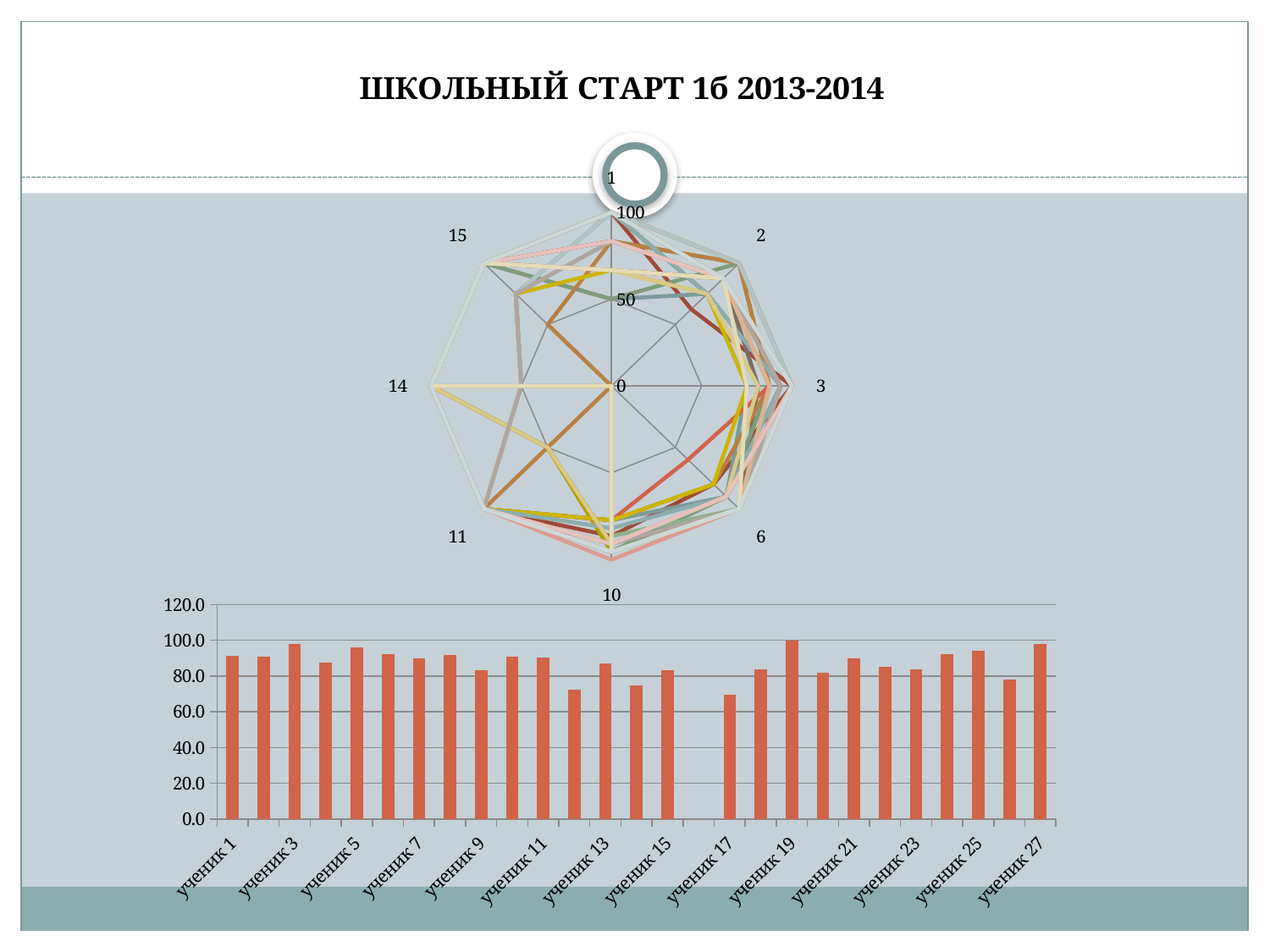
In the lower bar chart, is the value for ученик 19 greater or less than 80? greater In the lower bar chart, is the value for ученик 17 greater or less than 60? greater In the lower bar chart, is the value for ученик 25 greater or less than 80? greater In the lower bar chart, which is larger, the value for ученик 3 or ученик 13? ученик 3 What is the title of the slide? ШКОЛЬНЫЙ СТАРТ 1б 2013-2014 In the lower bar chart, which is larger, the value for ученик 19 or ученик 17? ученик 19 What kind of chart is the lower chart on the slide? bar chart What kind of chart is the upper chart on the slide? radar chart In the upper radar chart, what is the maximum value shown on the radial axis? 100 In the lower bar chart, which is larger, the value for ученик 5 or ученик 15? ученик 5